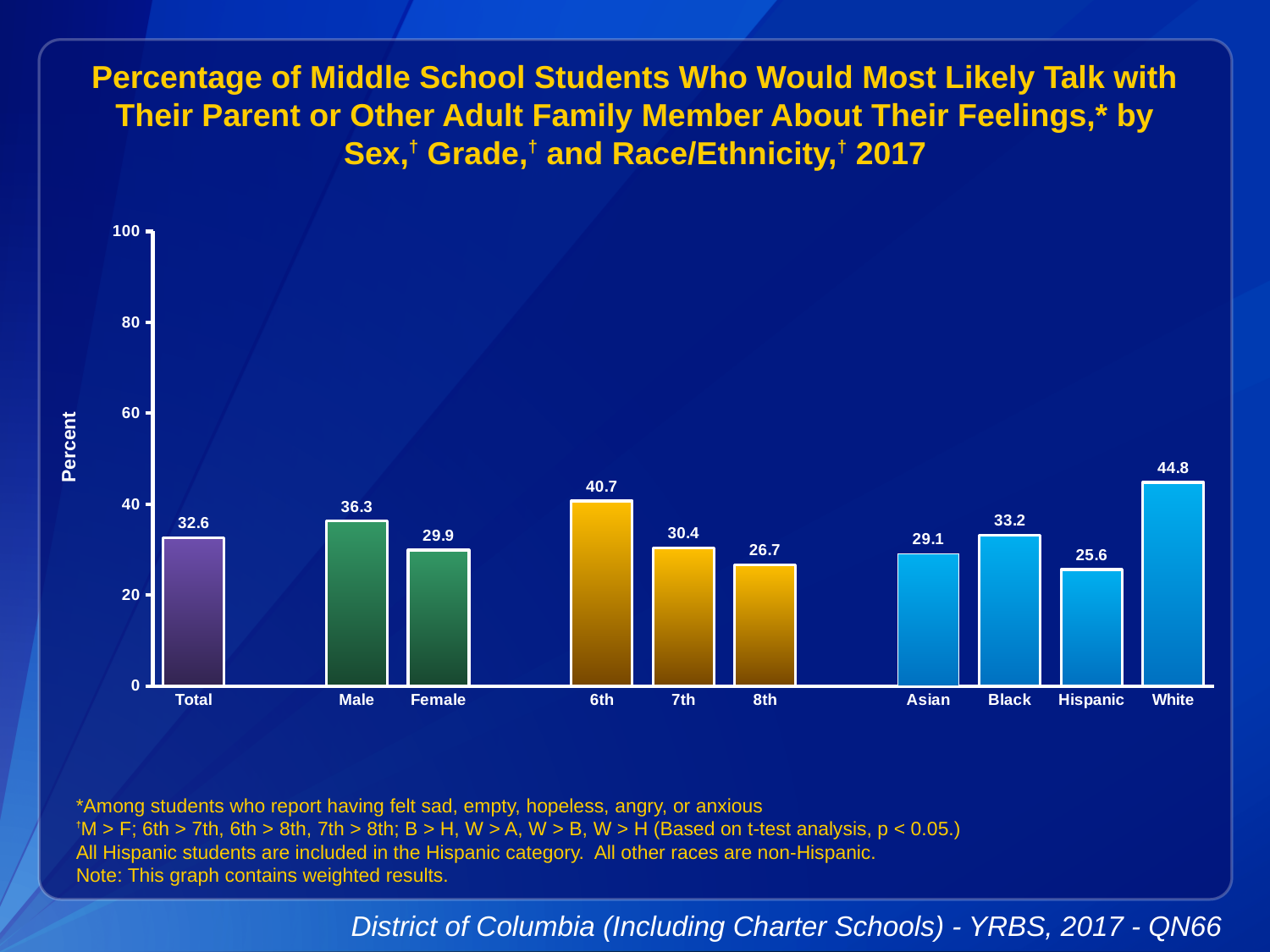
Which is larger, the value for Black or the value for Asian? Black Which category has the lowest value? Hispanic What is the value for Female? 29.9 How many categories are shown on the x axis? 10 What kind of chart is this? bar chart Is the value for White greater or less than 40? greater What is the value for Hispanic? 25.6 What is the value for 8th? 26.7 Which category has the highest value? White What is the difference between the values for Male and Female? 6.4 What is the difference between the values for 6th and 8th? 14.0 What is the value for Total? 32.6